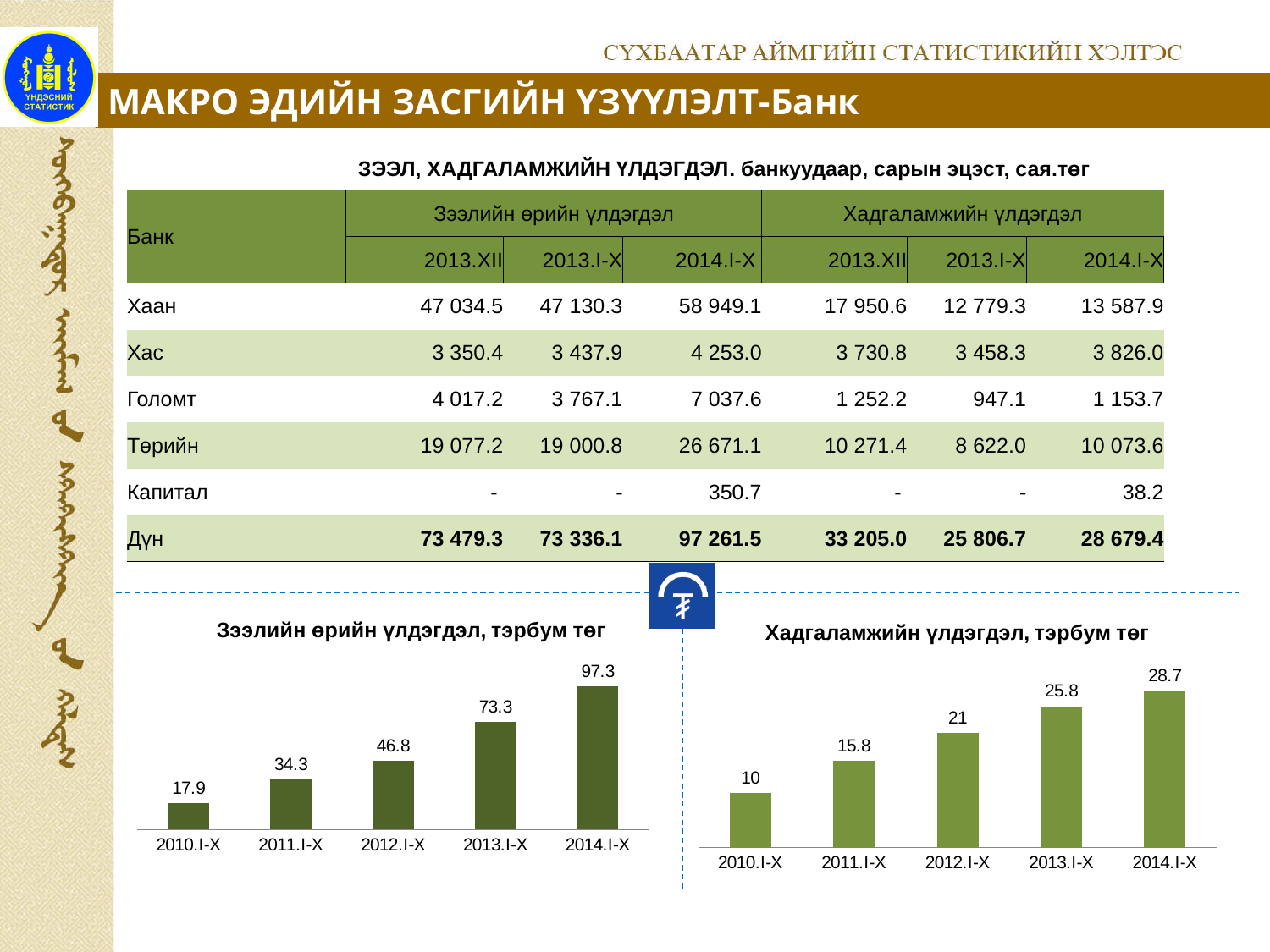
In the chart titled "Хадгаламжийн үлдэгдэл, тэрбум төг", which period has the lowest value? 2010.I-X What kind of chart is the chart titled "Зээлийн өрийн үлдэгдэл, тэрбум төг"? Bar chart In the chart titled "Хадгаламжийн үлдэгдэл, тэрбум төг", what is the value for 2012.I-X? 21 In the chart titled "Хадгаламжийн үлдэгдэл, тэрбум төг", do the values rise or fall from 2010.I-X to 2014.I-X? Rise In the chart titled "Хадгаламжийн үлдэгдэл, тэрбум төг", what is the value for 2013.I-X? 25.8 In the chart titled "Зээлийн өрийн үлдэгдэл, тэрбум төг", what is the value for 2010.I-X? 17.9 In the chart titled "Зээлийн өрийн үлдэгдэл, тэрбум төг", which period has the highest value? 2014.I-X In the chart titled "Зээлийн өрийн үлдэгдэл, тэрбум төг", what is the difference between the values for 2014.I-X and 2013.I-X? 24.0 In the chart titled "Зээлийн өрийн үлдэгдэл, тэрбум төг", what is the value for 2014.I-X? 97.3 In the chart titled "Зээлийн өрийн үлдэгдэл, тэрбум төг", which is larger, the value for 2012.I-X or 2011.I-X? 2012.I-X In the chart titled "Хадгаламжийн үлдэгдэл, тэрбум төг", what is the difference between the values for 2011.I-X and 2010.I-X? 5.8 How many bars are shown in the chart titled "Хадгаламжийн үлдэгдэл, тэрбум төг"? 5